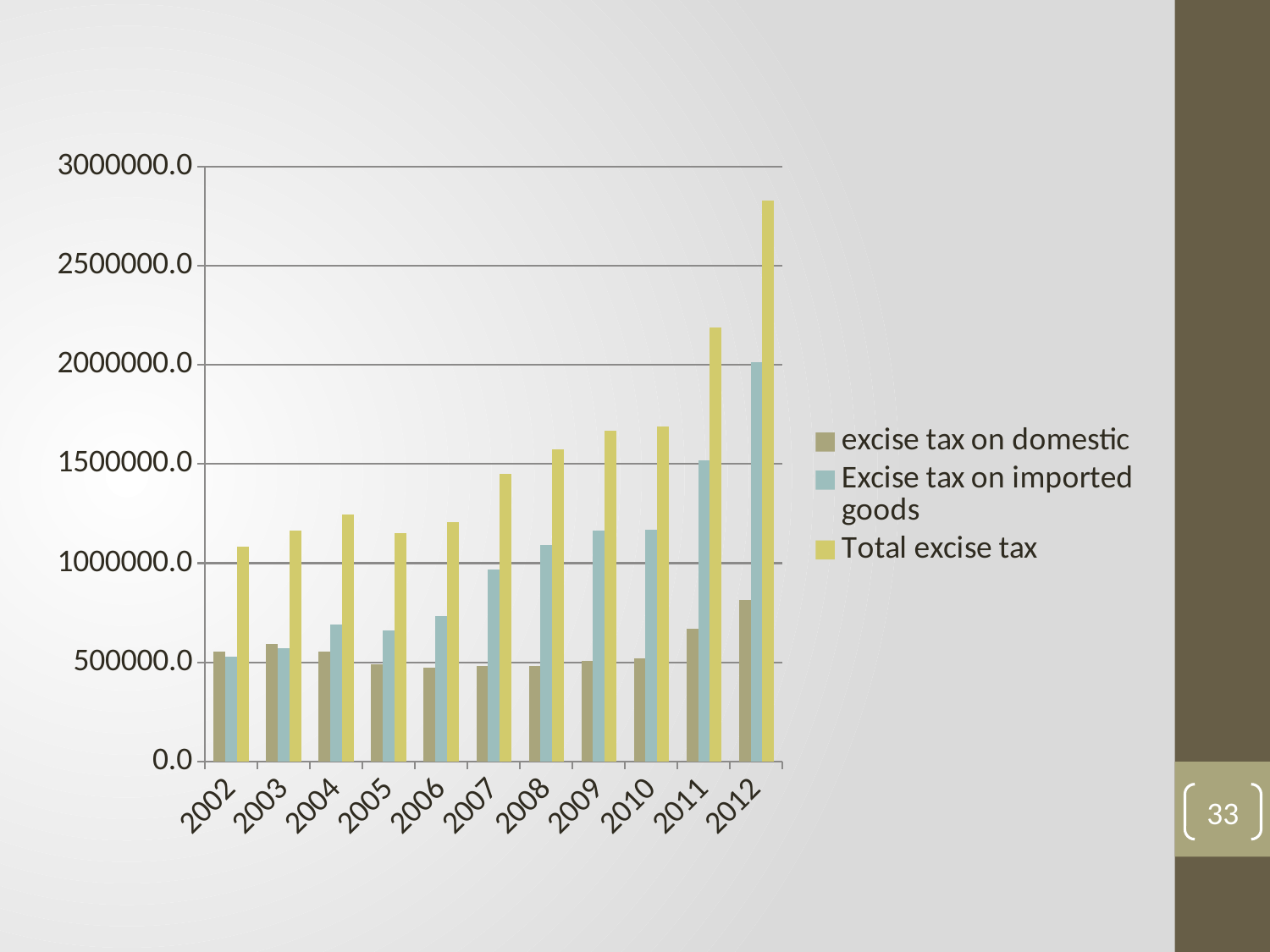
Which series is shown in yellow in the chart? Total excise tax Is the value for Total excise tax in 2012 greater or less than 2500000.0? greater Does Excise tax on imported goods generally rise or fall from 2002 to 2012? rise In which year is Excise tax on imported goods highest? 2012 In 2012, which is larger: excise tax on domestic or Excise tax on imported goods? Excise tax on imported goods Is the value for Excise tax on imported goods in 2011 greater or less than 1000000.0? greater How many series does the chart's legend list? 3 How many years are shown on the x axis of the chart? 11 What kind of chart is shown on the slide? bar chart In which year is Total excise tax lowest? 2002 In which year is Total excise tax highest? 2012 Is the value for excise tax on domestic in 2012 greater or less than 1000000.0? less